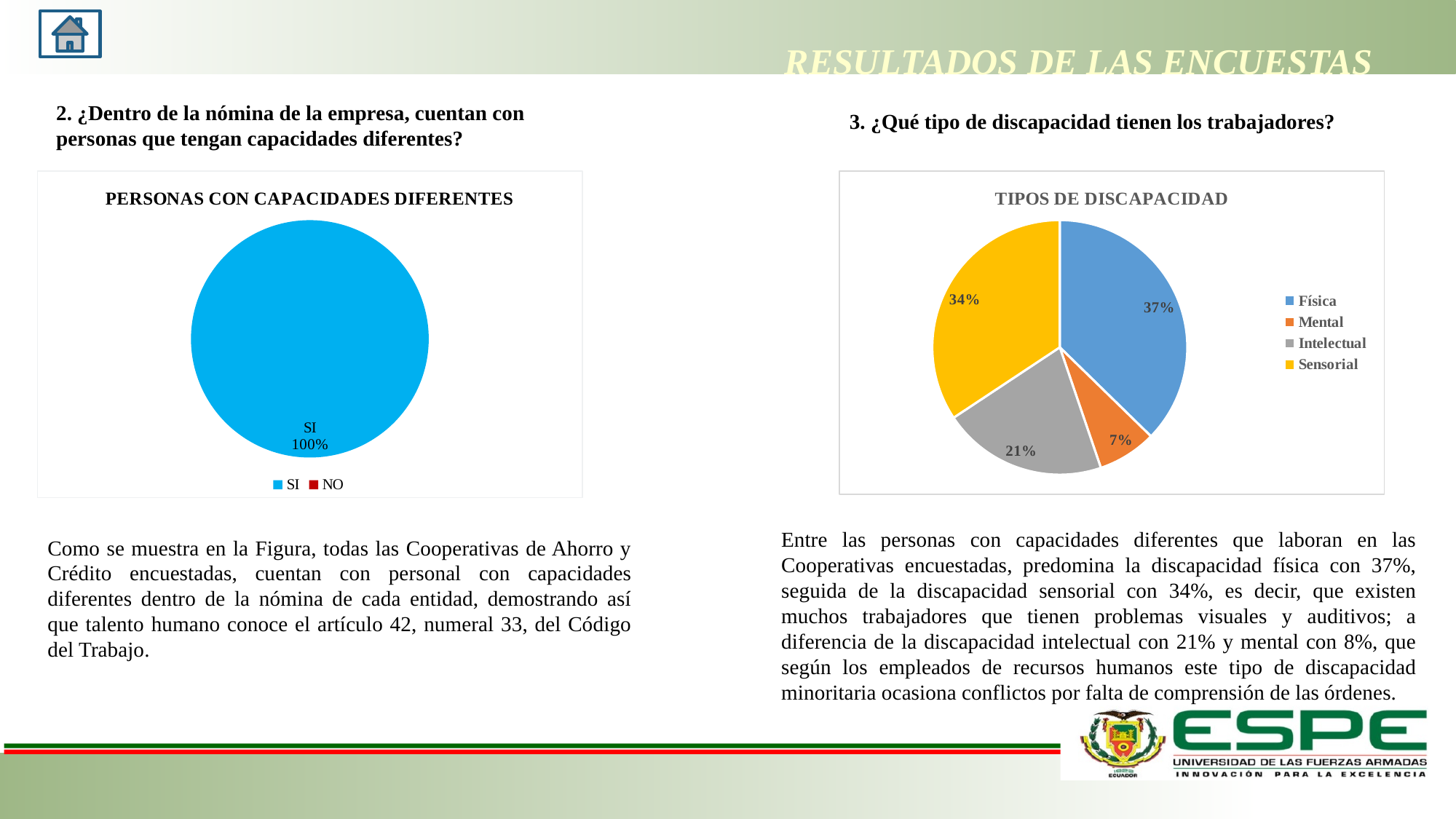
In the 'PERSONAS CON CAPACIDADES DIFERENTES' chart, what share does SI have? 100% What type of chart is 'PERSONAS CON CAPACIDADES DIFERENTES'? Pie chart In the 'TIPOS DE DISCAPACIDAD' chart, what share does Sensorial have? 34% In the 'TIPOS DE DISCAPACIDAD' chart, what share does Física have? 37% In the 'TIPOS DE DISCAPACIDAD' chart, which category has the largest slice? Física In the 'TIPOS DE DISCAPACIDAD' chart, what is the difference in percentage points between Intelectual and Mental? 14 In the 'TIPOS DE DISCAPACIDAD' chart, which is larger, Sensorial or Intelectual? Sensorial In the 'TIPOS DE DISCAPACIDAD' chart, which category has the smallest slice? Mental In the 'PERSONAS CON CAPACIDADES DIFERENTES' chart, what colour is the SI slice? Blue In the 'TIPOS DE DISCAPACIDAD' chart, how many categories does the legend list? 4